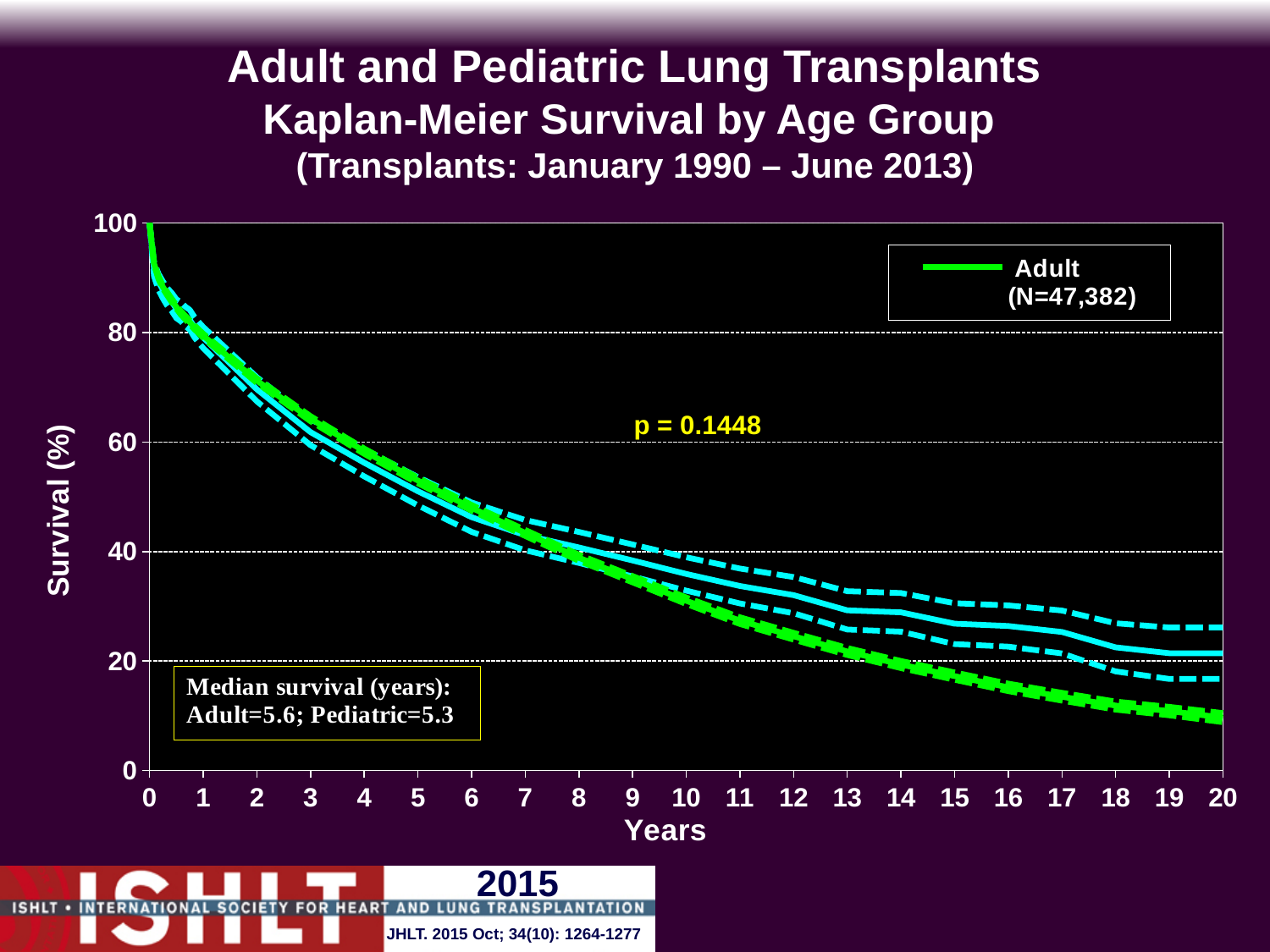
Which group has the longer median survival, Adult or Pediatric? Adult Is the Adult survival at 10 years greater or less than 40%? less What is the difference in median survival (years) between the Adult and Pediatric groups? 0.3 What p value is printed on the chart? p = 0.1448 What is the median survival in years for the Pediatric group? 5.3 What is the label of the y axis? Survival (%) Does survival rise or fall as years since transplant increase? fall What is the N for the Adult group shown in the legend? 47,382 What kind of chart is shown on the slide? line chart What is the median survival in years for the Adult group? 5.6 Is the Adult survival at 5 years greater or less than 40%? greater Is the Adult survival at 20 years greater or less than 20%? less